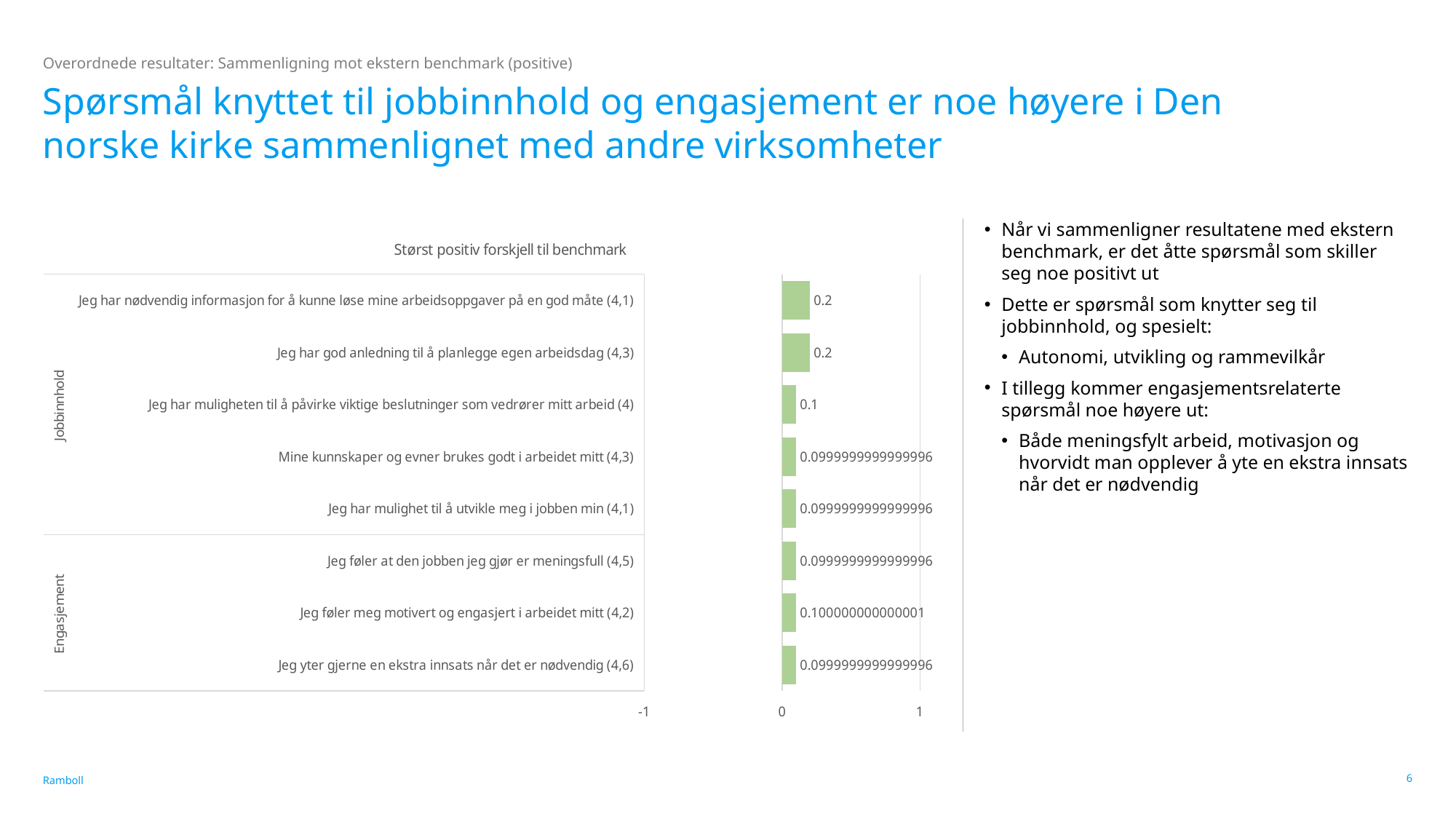
Is the value for "Jeg føler at den jobben jeg gjør er meningsfull (4,5)" greater or less than 1? less Which is larger: the value for "Jeg har god anledning til å planlegge egen arbeidsdag (4,3)" or the value for "Jeg har mulighet til å utvikle meg i jobben min (4,1)"? Jeg har god anledning til å planlegge egen arbeidsdag (4,3) What is the highest value shown in the chart? 0.2 What is the value for "Jeg har muligheten til å påvirke viktige beslutninger som vedrører mitt arbeid (4)"? 0.1 What is the title of the chart? Størst positiv forskjell til benchmark What kind of chart is shown on the slide? bar chart What is the value shown for "Jeg yter gjerne en ekstra innsats når det er nødvendig (4,6)"? 0.0999999999999996 What are the two group labels shown along the left side of the chart? Jobbinnhold and Engasjement How many categories (questions) are plotted in the chart? 8 What is the value for "Jeg har nødvendig informasjon for å kunne løse mine arbeidsoppgaver på en god måte (4,1)"? 0.2 What is the value shown for "Jeg føler meg motivert og engasjert i arbeidet mitt (4,2)"? 0.100000000000001 What is the difference between the value for "Jeg har god anledning til å planlegge egen arbeidsdag (4,3)" and the value for "Jeg har muligheten til å påvirke viktige beslutninger som vedrører mitt arbeid (4)"? 0.1